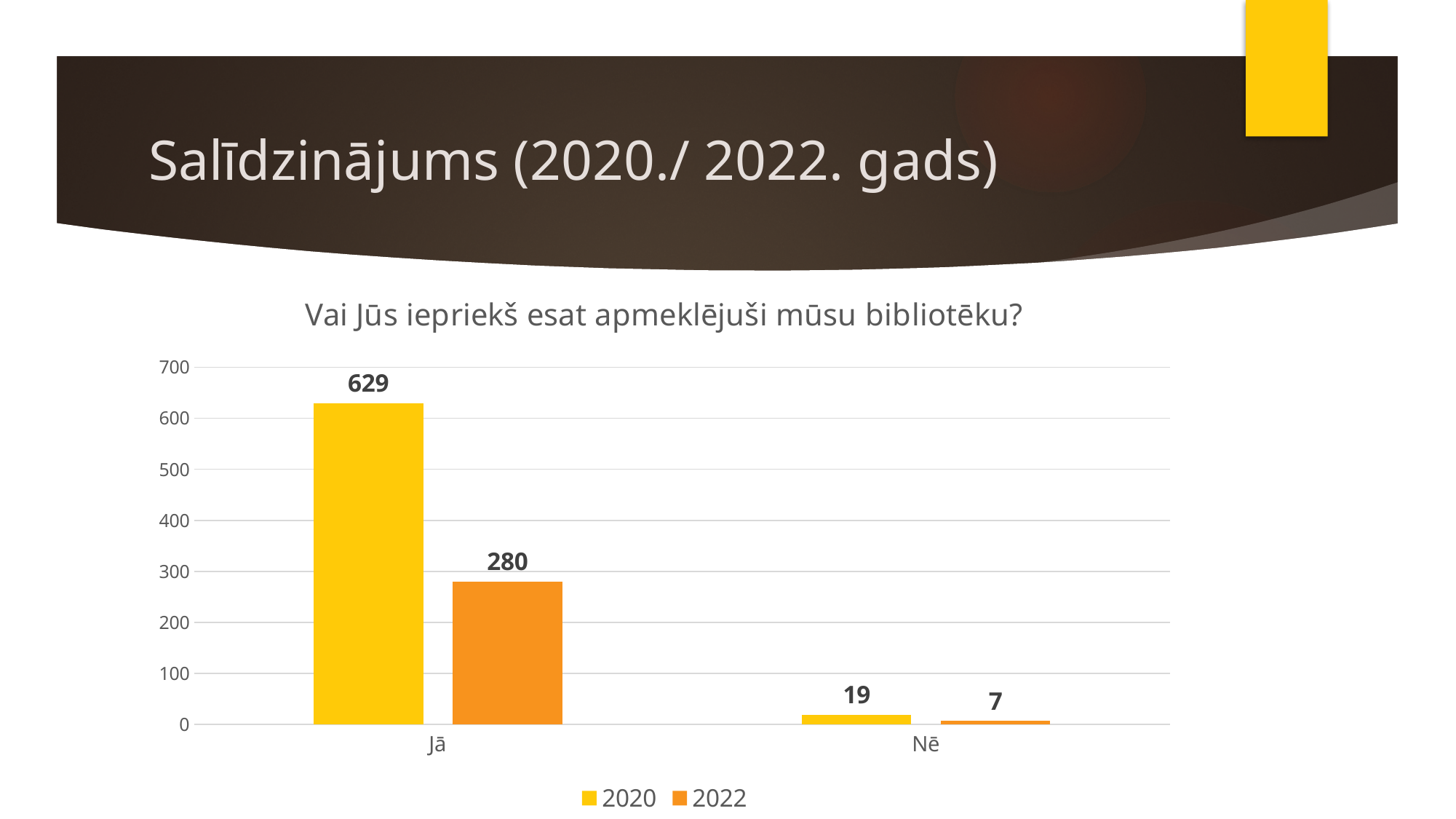
What is the value for "Nē" in the 2022 series? 7 What is the difference between the 2020 and 2022 values for "Nē"? 12 What is the difference between the 2020 and 2022 values for "Jā"? 349 What kind of chart is shown on the slide? Bar chart Which category has the lowest value in the 2022 series? Nē How many categories are shown on the x axis? 2 How many series does the legend list? 2 Which is larger for "Jā": the 2020 value or the 2022 value? 2020 Which category has the highest value in the 2020 series? Jā What is the value for "Nē" in the 2020 series? 19 What is the value for "Jā" in the 2020 series? 629 What is the value for "Jā" in the 2022 series? 280